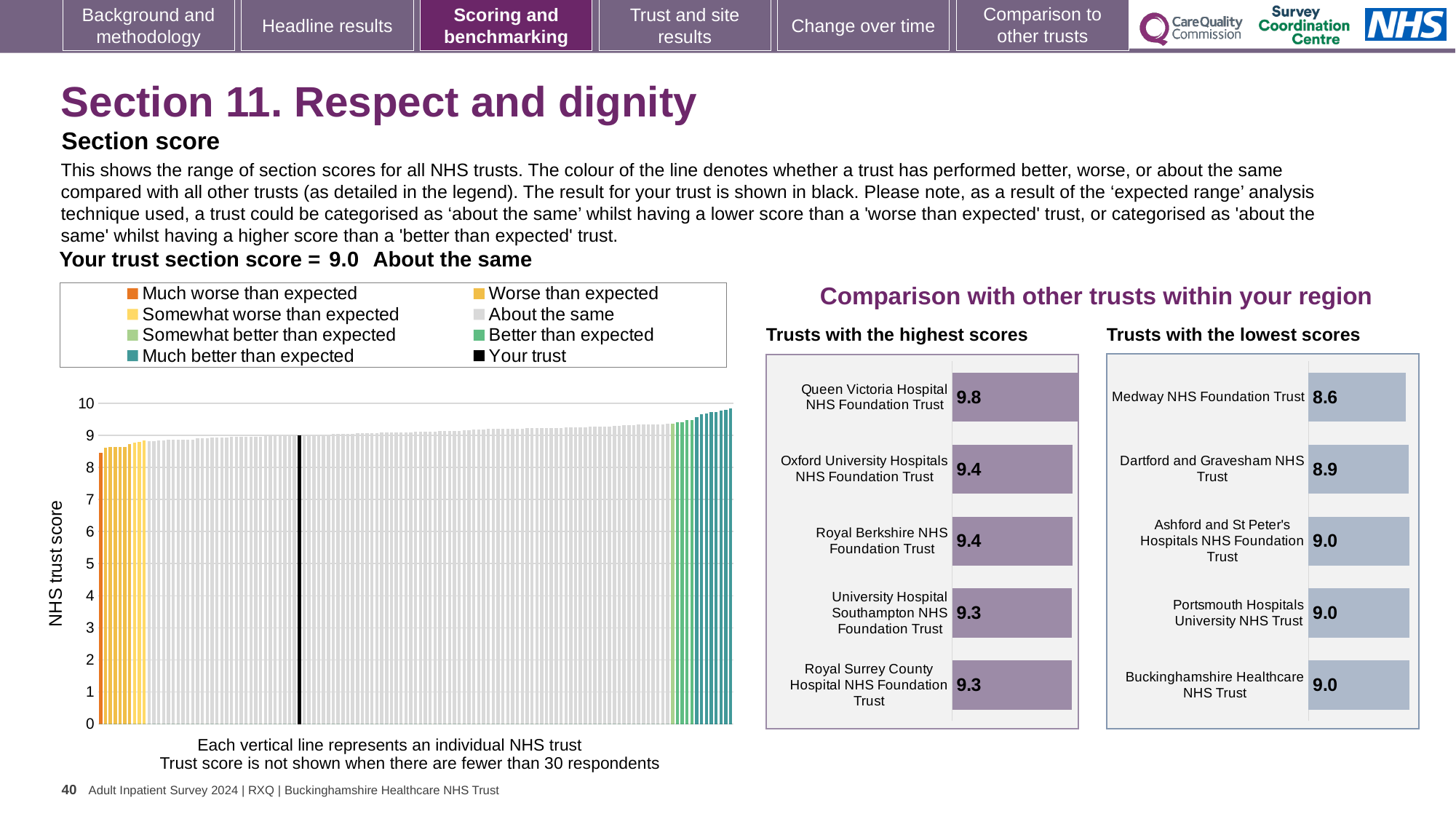
In the 'Trusts with the highest scores' chart, what is the difference between the scores of Queen Victoria Hospital NHS Foundation Trust and Royal Surrey County Hospital NHS Foundation Trust? 0.5 In the 'Trusts with the highest scores' chart, how many trusts are shown? 5 In the 'Trusts with the lowest scores' chart, which trust has the lowest score? Medway NHS Foundation Trust In the 'Trusts with the lowest scores' chart, which has the larger score: Medway NHS Foundation Trust or Dartford and Gravesham NHS Trust? Dartford and Gravesham NHS Trust How many entries does the legend above the main NHS trust score chart list? 8 In the main NHS trust score chart on the left, what is the section score for 'Your trust' (the black bar)? 9.0 In the 'Trusts with the lowest scores' chart, what is the score for Buckinghamshire Healthcare NHS Trust? 9.0 In the 'Trusts with the lowest scores' chart, what is the score for Medway NHS Foundation Trust? 8.6 In the 'Trusts with the highest scores' chart, which trust has the highest score? Queen Victoria Hospital NHS Foundation Trust In the main NHS trust score chart on the left, is the value of the leftmost (orange) bar greater or less than 9? less In the 'Trusts with the highest scores' chart, what is the score for Queen Victoria Hospital NHS Foundation Trust? 9.8 What kind of chart is the main NHS trust score chart on the left? Bar chart